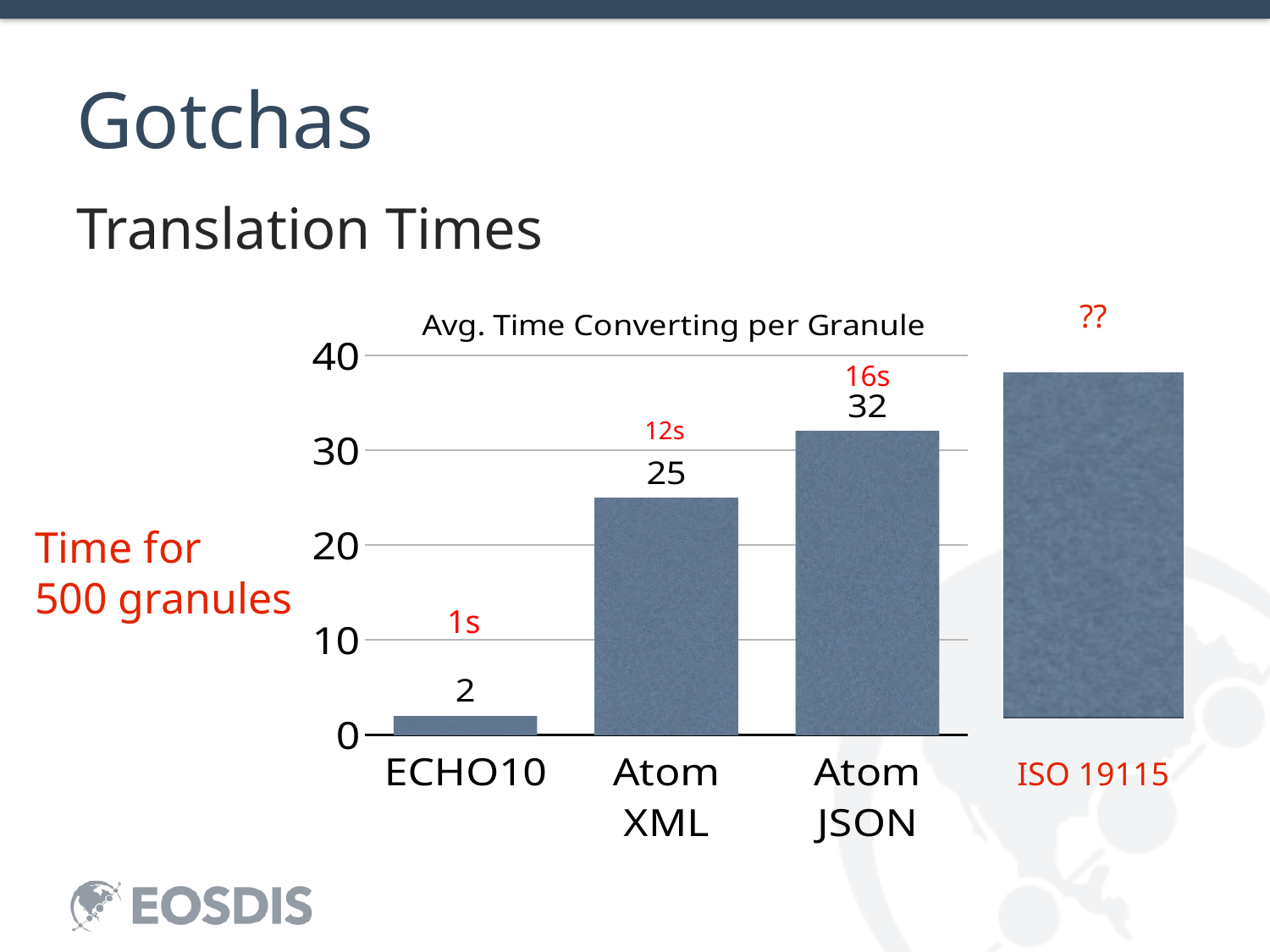
Among the labelled bars, which category has the highest average time converting per granule? Atom JSON What kind of chart is shown on the slide? bar chart What is the difference between the values for Atom JSON and Atom XML? 7 What is the value for Atom JSON in the Avg. Time Converting per Granule chart? 32 Which is larger, the value for Atom XML or the value for ECHO10? Atom XML What is the title of the chart? Avg. Time Converting per Granule What is the difference between the values for Atom XML and ECHO10? 23 What red annotation is shown above the Atom XML bar for the time for 500 granules? 12s What is the value for ECHO10 in the Avg. Time Converting per Granule chart? 2 Which category has the lowest average time converting per granule? ECHO10 Is the value for Atom JSON greater or less than 30? greater What is the value for Atom XML in the Avg. Time Converting per Granule chart? 25